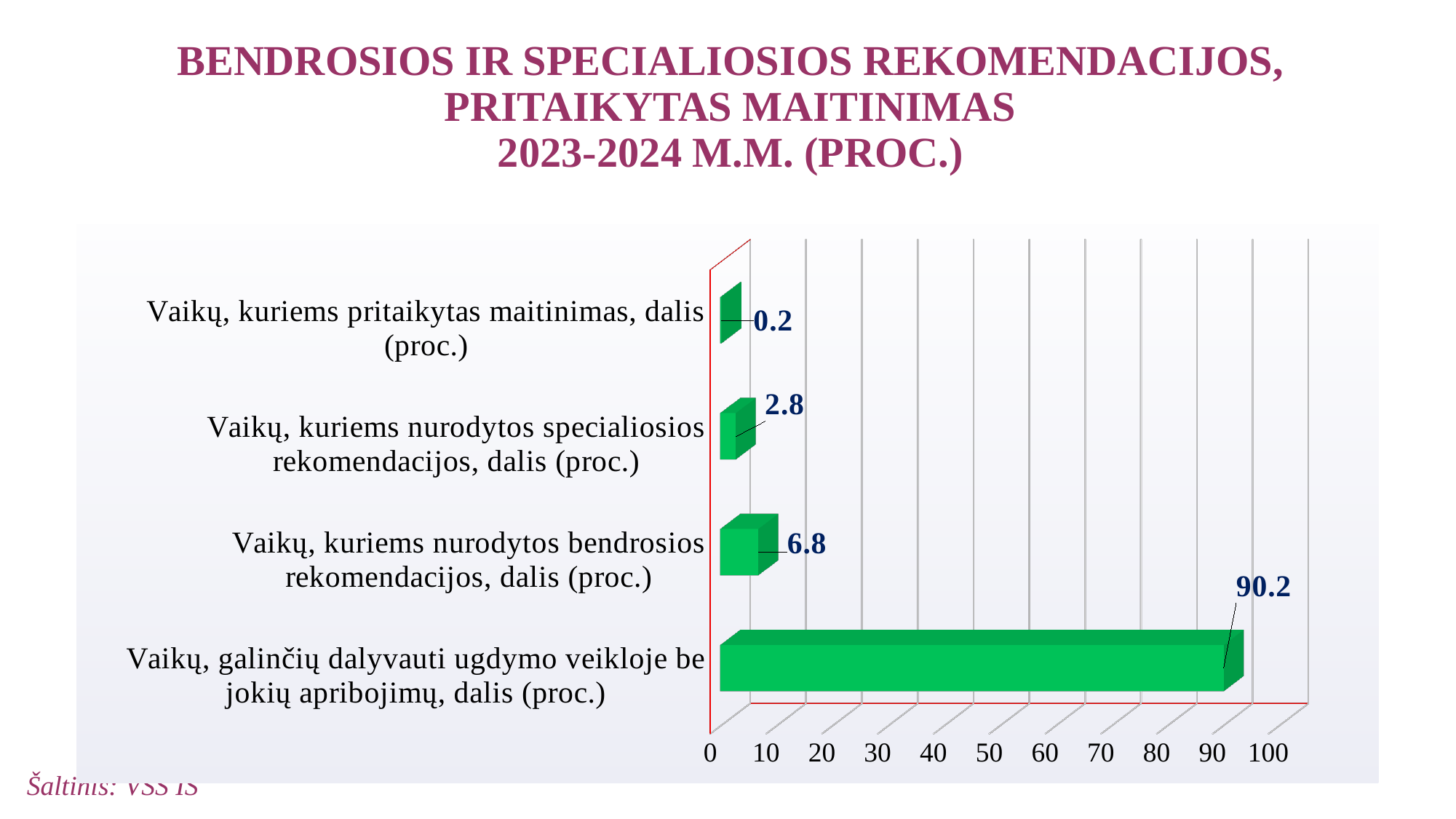
What is the value for 'Vaikų, kuriems nurodytos specialiosios rekomendacijos, dalis (proc.)'? 2.8 What is the value for 'Vaikų, kuriems nurodytos bendrosios rekomendacijos, dalis (proc.)'? 6.8 How many categories are shown in the chart? 4 Which category has the highest value? Vaikų, galinčių dalyvauti ugdymo veikloje be jokių apribojimų, dalis (proc.) What is the value for 'Vaikų, kuriems pritaikytas maitinimas, dalis (proc.)'? 0.2 What kind of chart is shown on the slide? bar chart Which is larger: the value for 'Vaikų, kuriems nurodytos specialiosios rekomendacijos' or the value for 'Vaikų, kuriems pritaikytas maitinimas'? Vaikų, kuriems nurodytos specialiosios rekomendacijos Which category has the lowest value? Vaikų, kuriems pritaikytas maitinimas, dalis (proc.) What is the highest tick value shown on the value axis? 100 What is the value for 'Vaikų, galinčių dalyvauti ugdymo veikloje be jokių apribojimų, dalis (proc.)'? 90.2 What is the difference between the value for 'Vaikų, kuriems nurodytos bendrosios rekomendacijos' and the value for 'Vaikų, kuriems nurodytos specialiosios rekomendacijos'? 4.0 Is the value for 'Vaikų, galinčių dalyvauti ugdymo veikloje be jokių apribojimų' greater or less than 80? greater